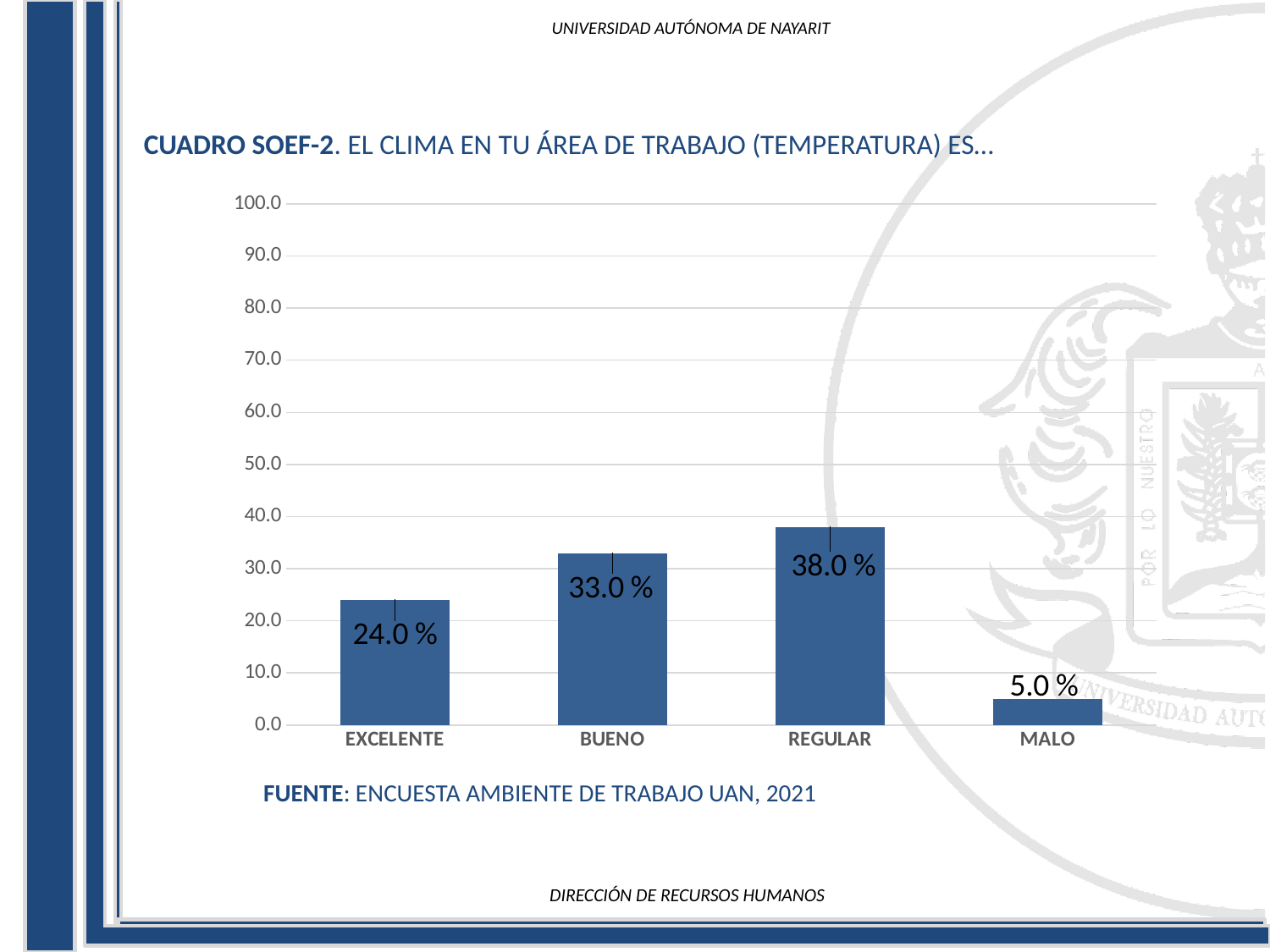
Which category has the lowest value? MALO What is the value for BUENO? 33.0 % What is the value for EXCELENTE? 24.0 % Which category has the highest value? REGULAR What is the value for REGULAR? 38.0 % What is the difference between the values for EXCELENTE and MALO? 19.0 % Is the value for REGULAR greater or less than 40.0? less What kind of chart is shown on the slide? bar chart What is the value for MALO? 5.0 % What is the difference between the values for REGULAR and BUENO? 5.0 % How many categories are shown on the x axis? 4 Which is larger, the value for BUENO or the value for EXCELENTE? BUENO